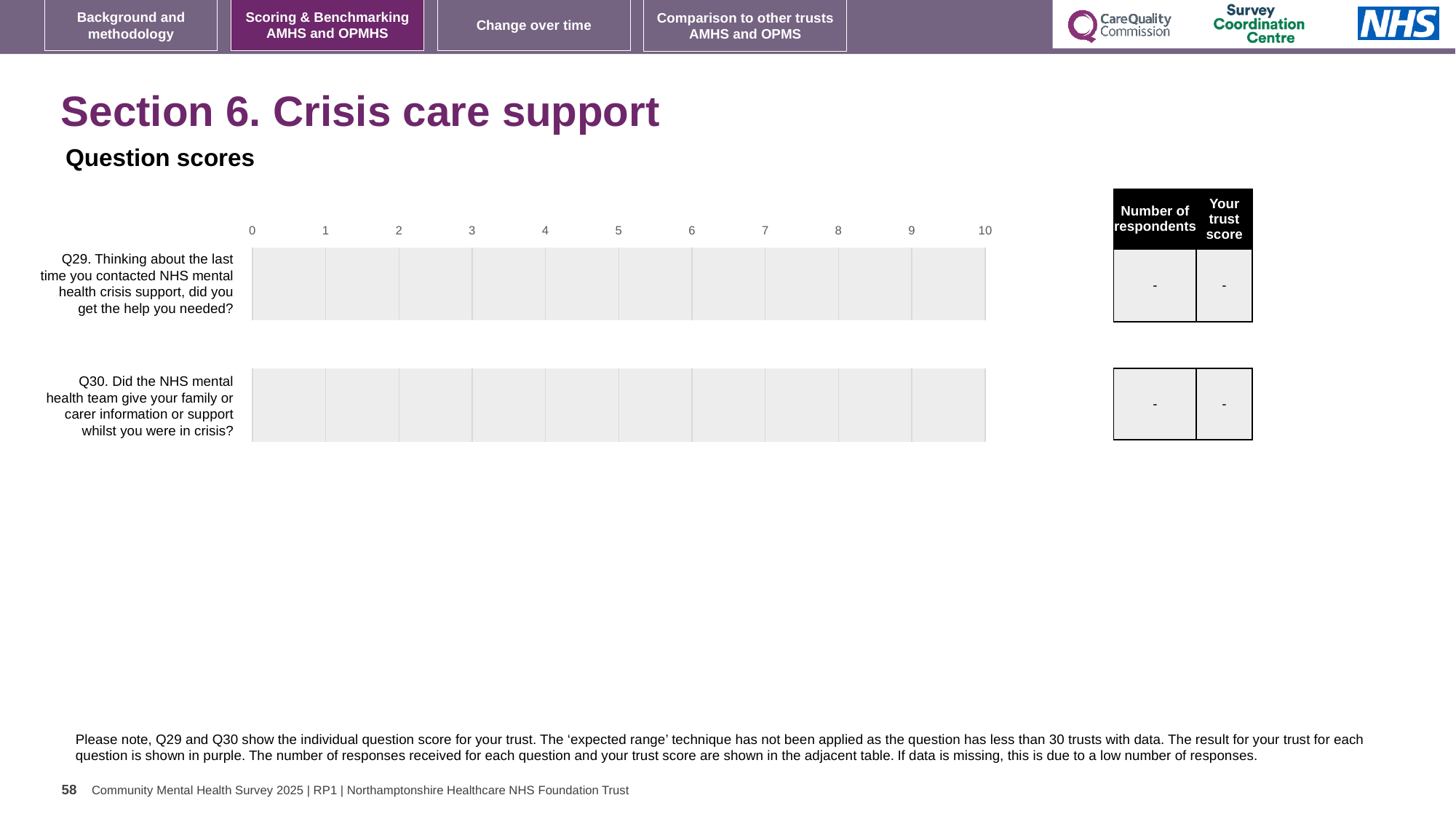
How many questions (categories) are listed on the chart? 2 What is shown in the 'Number of respondents' column for Q30? - What is the highest value shown on the chart's axis? 10 What kind of chart is shown on the slide? bar chart What is the heading above the chart? Question scores What is shown in the 'Your trust score' column for Q29? -